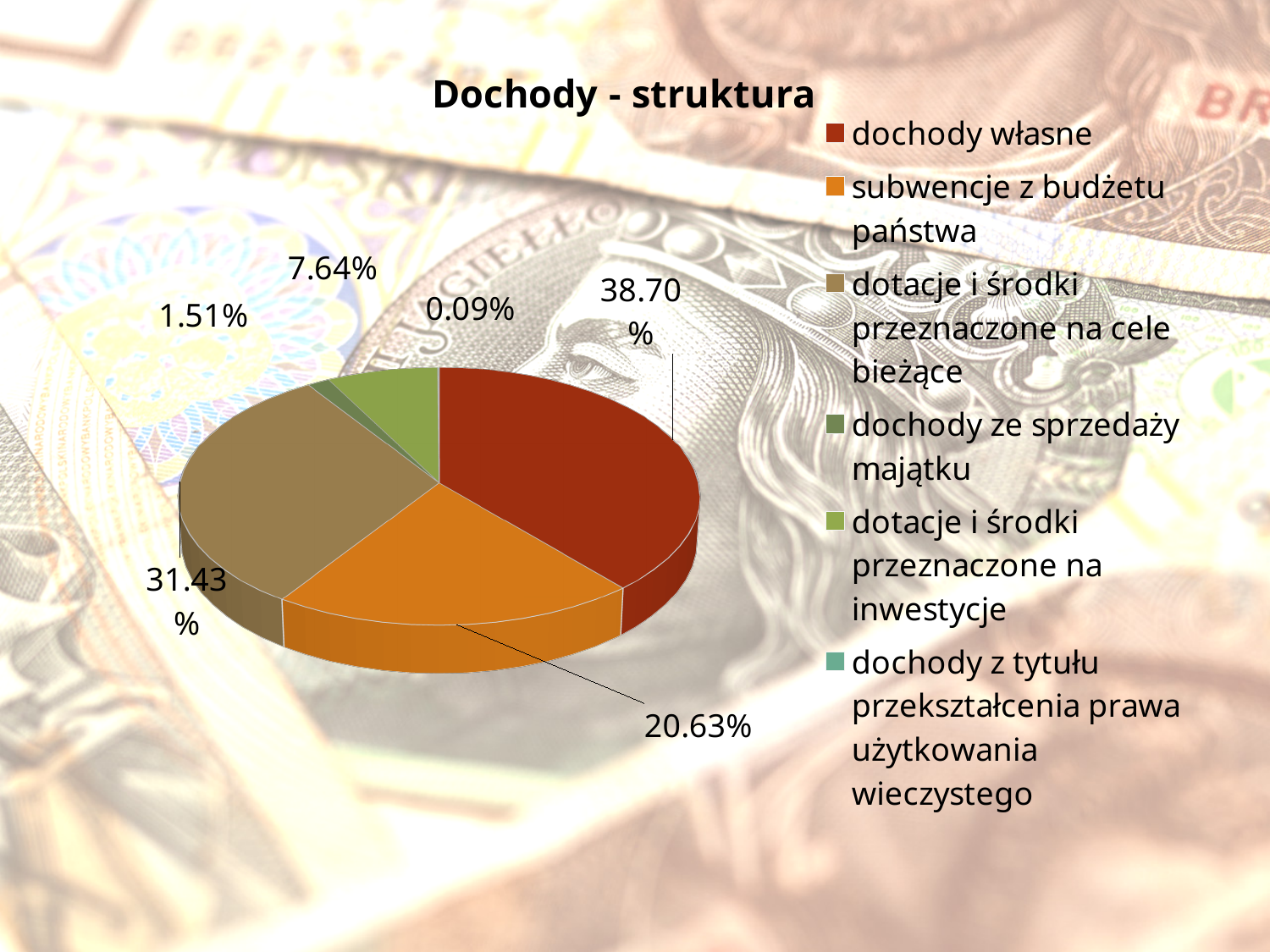
What type of chart is shown on the slide? pie chart What share of the pie is 'dochody ze sprzedaży majątku'? 1.51% What share of the pie is 'subwencje z budżetu państwa'? 20.63% How many entries does the chart legend list? 6 What share of the pie is 'dotacje i środki przeznaczone na cele bieżące'? 31.43% Which category has the largest share of the pie? dochody własne What is the difference between the shares of 'dochody własne' and 'subwencje z budżetu państwa'? 18.07% Which is larger: the share of 'dotacje i środki przeznaczone na cele bieżące' or 'subwencje z budżetu państwa'? dotacje i środki przeznaczone na cele bieżące What is the title of the chart? Dochody - struktura Which category has the smallest share of the pie? dochody z tytułu przekształcenia prawa użytkowania wieczystego